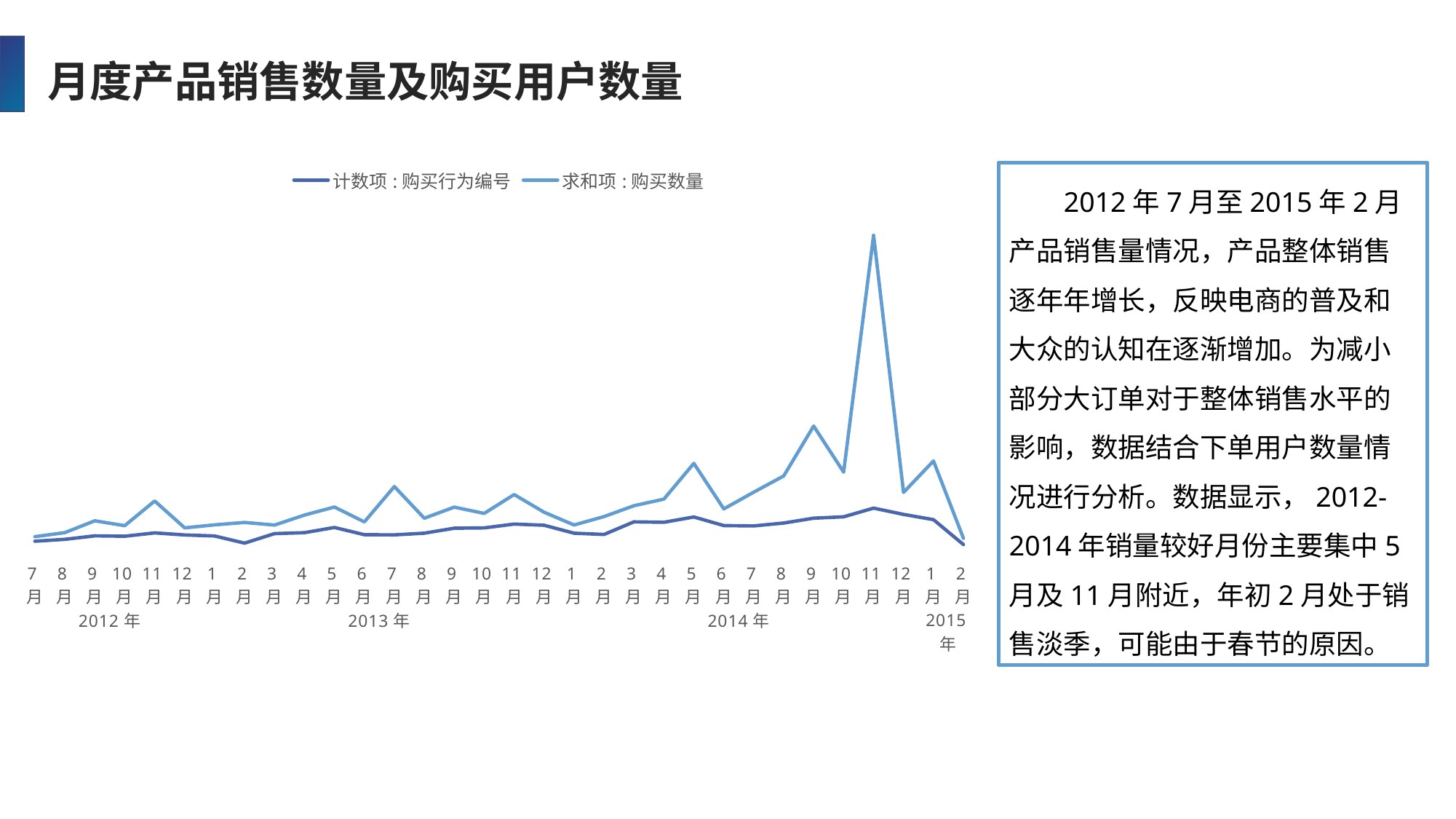
What is the title of the slide containing the chart? 月度产品销售数量及购买用户数量 For the 求和项：购买数量 series, which is larger: the value in 2014年11月 or the value in 2014年9月? 2014年11月 In which month does the 求和项：购买数量 series reach its highest value? 2014年11月 Does the 求和项：购买数量 series rise or fall from 2014年10月 to 2014年11月? rise In which month does the 计数项：购买行为编号 series reach its highest value? 2014年11月 How many series does the chart legend list? 2 In 2014年11月, which series has the larger value: 求和项：购买数量 or 计数项：购买行为编号? 求和项：购买数量 Does the 求和项：购买数量 series rise or fall from 2014年11月 to 2014年12月? fall How many monthly data points are plotted along the x axis? 32 What are the two series named in the chart legend? 计数项：购买行为编号 and 求和项：购买数量 How many year groups are labeled on the x axis? 4 What kind of chart is shown on the slide? line chart